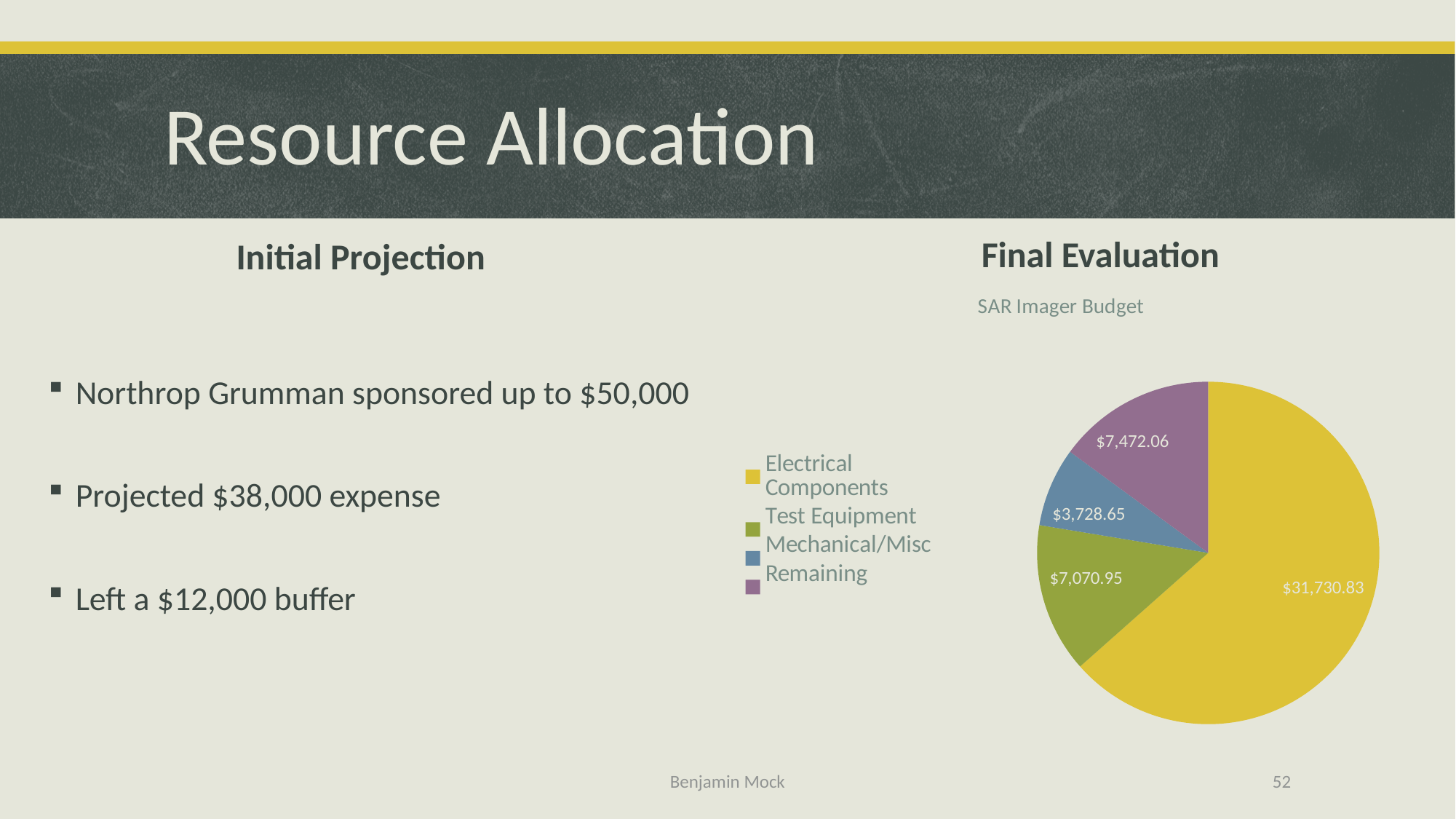
What is the title of the pie chart? SAR Imager Budget In the SAR Imager Budget pie chart, which is larger: Remaining or Test Equipment? Remaining Which category has the largest slice in the SAR Imager Budget pie chart? Electrical Components In the SAR Imager Budget pie chart, what is the value for Test Equipment? $7,070.95 In the SAR Imager Budget pie chart, what is the value for Mechanical/Misc? $3,728.65 How many categories does the SAR Imager Budget pie chart show? 4 In the SAR Imager Budget pie chart, what is the difference between Test Equipment and Mechanical/Misc? $3,342.30 In the SAR Imager Budget pie chart, what is the value for Remaining? $7,472.06 Which category has the smallest slice in the SAR Imager Budget pie chart? Mechanical/Misc In the SAR Imager Budget pie chart, what is the value for Electrical Components? $31,730.83 What type of chart is shown under Final Evaluation? Pie chart In the SAR Imager Budget pie chart, which colour represents Remaining? Purple